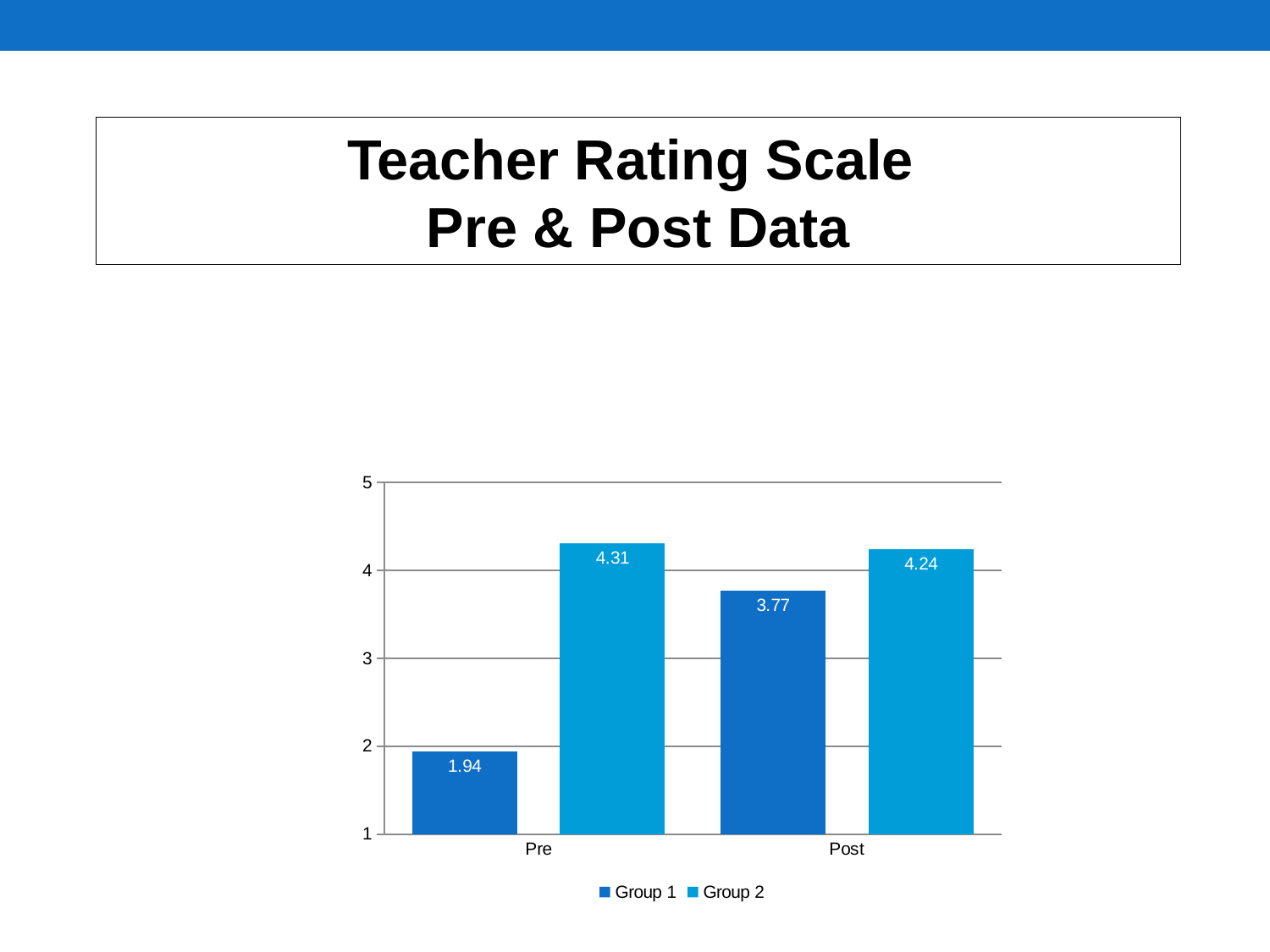
What is the value for Group 2 in the Post category? 4.24 What kind of chart is shown on the slide? Bar chart How many series does the legend list? 2 What is the difference between the Group 1 Post value and the Group 1 Pre value? 1.83 Is the value for Group 1 in the Post category greater or less than 3? greater How many categories are shown on the x axis? 2 What is the difference between the Group 2 Pre value and the Group 2 Post value? 0.07 Which bar has the lowest value on the chart? Group 1, Pre Which is larger, the Group 1 Pre value or the Group 2 Pre value? Group 2 Pre Which bar has the highest value on the chart? Group 2, Pre What is the value for Group 1 in the Pre category? 1.94 What is the value for Group 1 in the Post category? 3.77